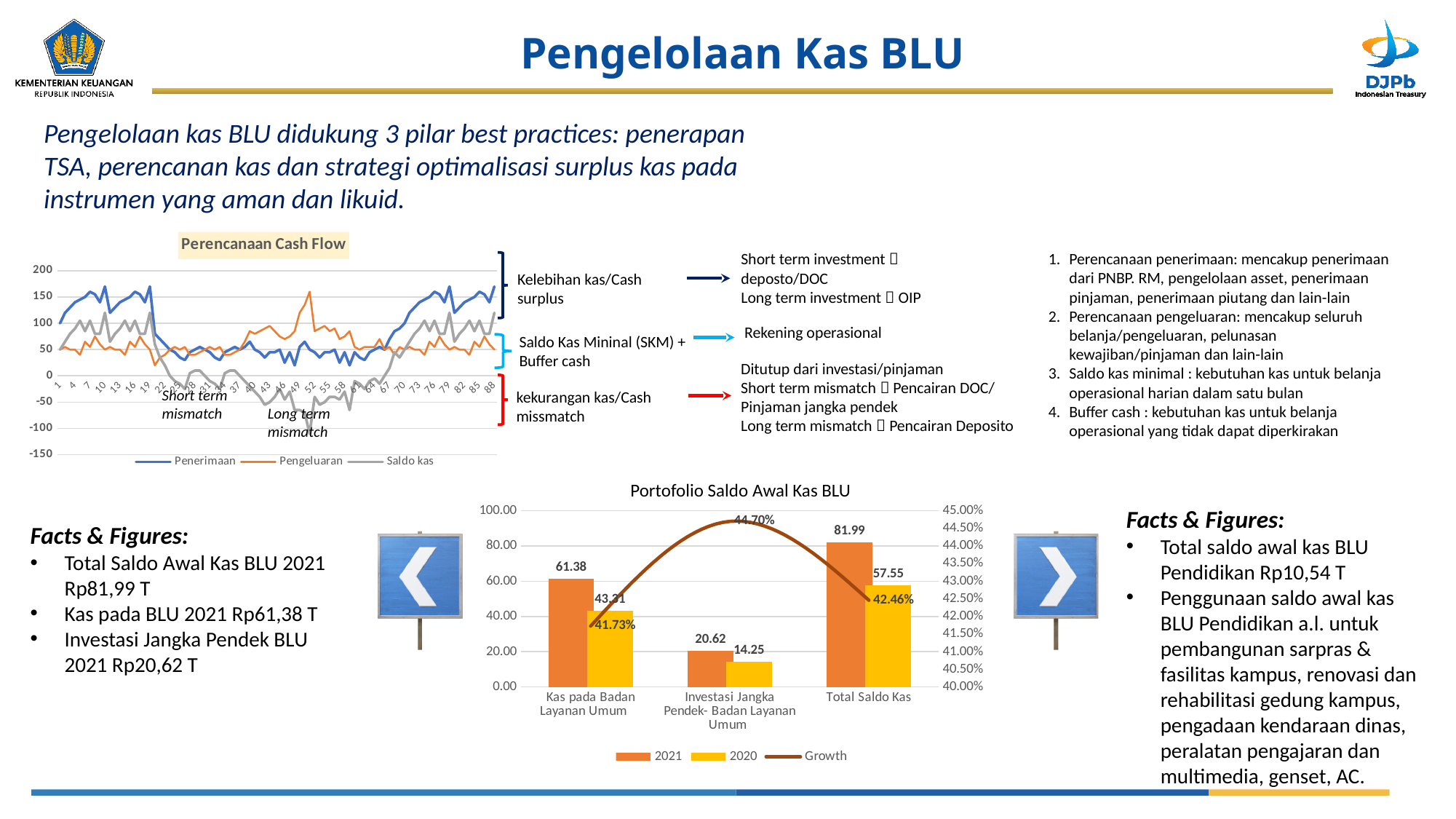
How many categories are shown on the x axis of the 'Portofolio Saldo Awal Kas BLU' chart? 3 In the 'Portofolio Saldo Awal Kas BLU' chart, which category has the highest 2021 value? Total Saldo Kas In the 'Portofolio Saldo Awal Kas BLU' chart, what is the 2020 value for Kas pada Badan Layanan Umum? 43.31 In the 'Portofolio Saldo Awal Kas BLU' chart, what is the difference between the 2021 and 2020 values for Total Saldo Kas? 24.44 What are the legend entries of the 'Perencanaan Cash Flow' chart? Penerimaan, Pengeluaran, Saldo kas In the 'Portofolio Saldo Awal Kas BLU' chart, what is the 2021 value for Total Saldo Kas? 81.99 In the 'Portofolio Saldo Awal Kas BLU' chart, what is the Growth value for Investasi Jangka Pendek- Badan Layanan Umum? 44.70% What kind of chart is the 'Perencanaan Cash Flow' chart? line chart In the 'Portofolio Saldo Awal Kas BLU' chart, which has the larger Growth value: Kas pada Badan Layanan Umum or Total Saldo Kas? Total Saldo Kas In the 'Portofolio Saldo Awal Kas BLU' chart, what is the difference between the 2021 and 2020 values for Kas pada Badan Layanan Umum? 18.07 How many series does the legend of the 'Portofolio Saldo Awal Kas BLU' chart list? 3 In the 'Portofolio Saldo Awal Kas BLU' chart, which category has the lowest 2020 value? Investasi Jangka Pendek- Badan Layanan Umum